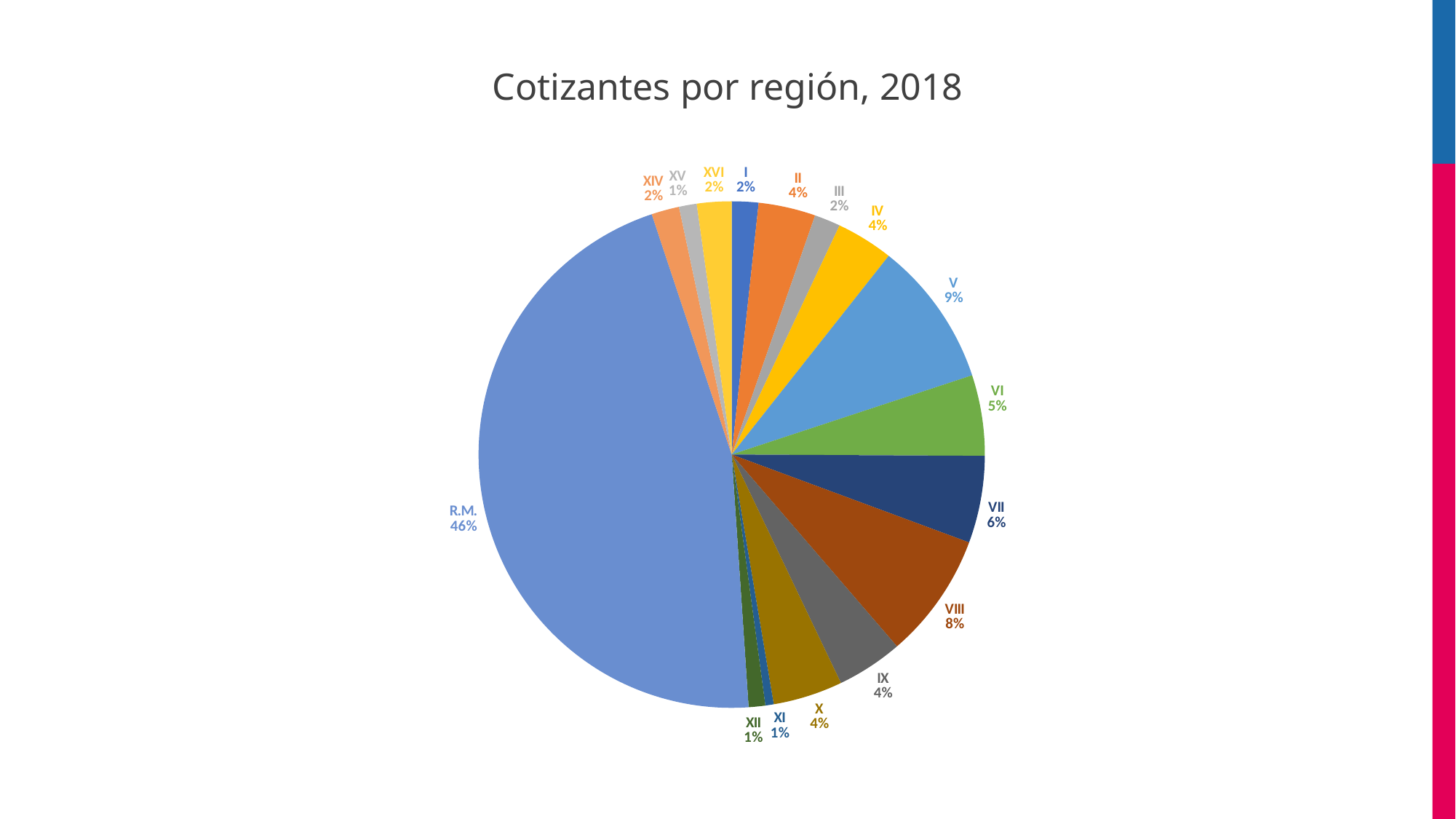
Which has a larger share, region VIII or region IX? VIII How many slices does the pie chart have? 16 What percentage is shown for region VIII? 8% What is the title of the chart? Cotizantes por región, 2018 What is the difference in percentage points between region V and region VI? 4 What share of the pie does R.M. have? 46% What percentage is shown for region V? 9% What percentage is shown for region VII? 6% What kind of chart is shown on the slide? pie chart What is the combined share of regions XI and XII? 2% Which region has the largest slice of the pie? R.M. What percentage is shown for region XV? 1%